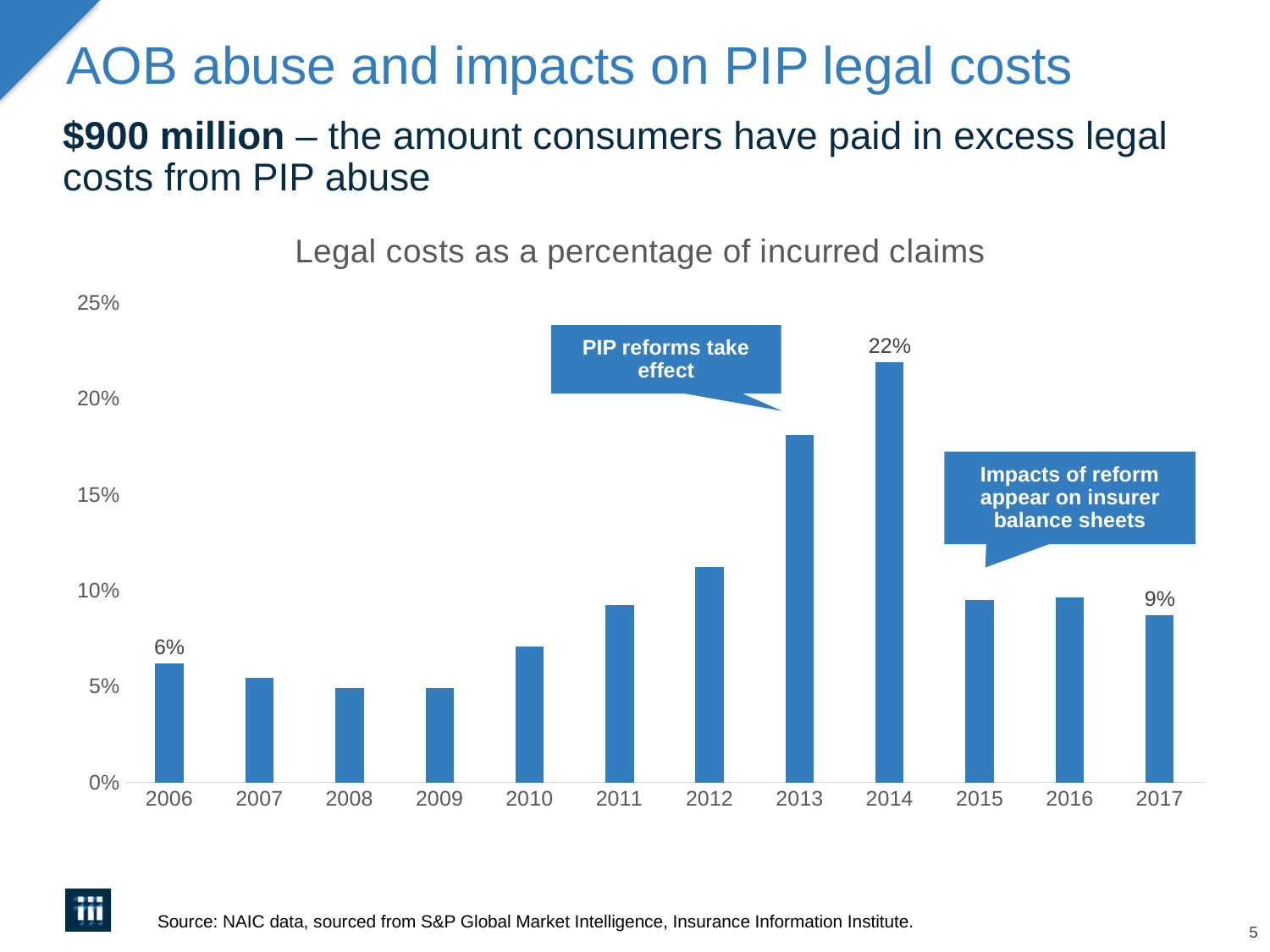
Which year has the highest legal costs as a percentage of incurred claims? 2014 What is the value for 2014? 22% Is the value for 2013 greater or less than 15%? greater What is the difference between the values for 2014 and 2006? 16% Which is larger, the value for 2017 or the value for 2006? 2017 What is the difference between the values for 2014 and 2017? 13% What is the value for 2006? 6% Do the values rise or fall from 2009 to 2014? Rise Is the value for 2010 greater or less than 5%? greater How many years are shown on the x axis? 12 What is the value for 2017? 9% What kind of chart is shown on the slide? Bar chart